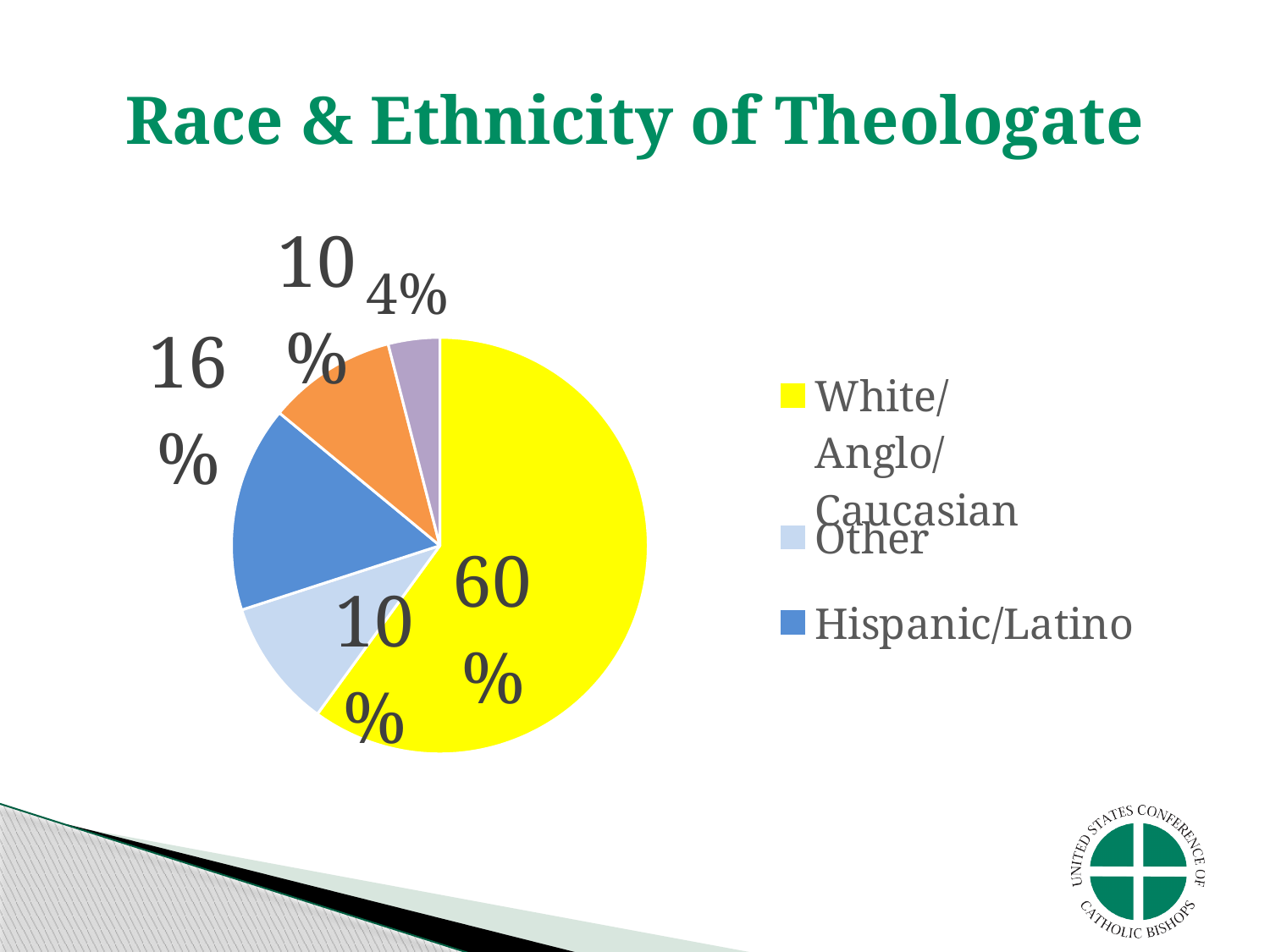
How many slices does the pie chart have? 5 Which is larger, the Hispanic/Latino share or the Other share? Hispanic/Latino What is the smallest percentage shown on the pie chart? 4% What colour is the White/Anglo/Caucasian slice? Yellow What type of chart is shown on the slide? Pie chart What is the difference in percentage points between the White/Anglo/Caucasian share and the Hispanic/Latino share? 44 What percentage of the pie is Hispanic/Latino? 16% How many entries does the legend list? 3 What is the title of the chart? Race & Ethnicity of Theologate Which category has the largest share of the pie? White/Anglo/Caucasian What percentage of the pie is White/Anglo/Caucasian? 60% What percentage of the pie is labelled Other? 10%